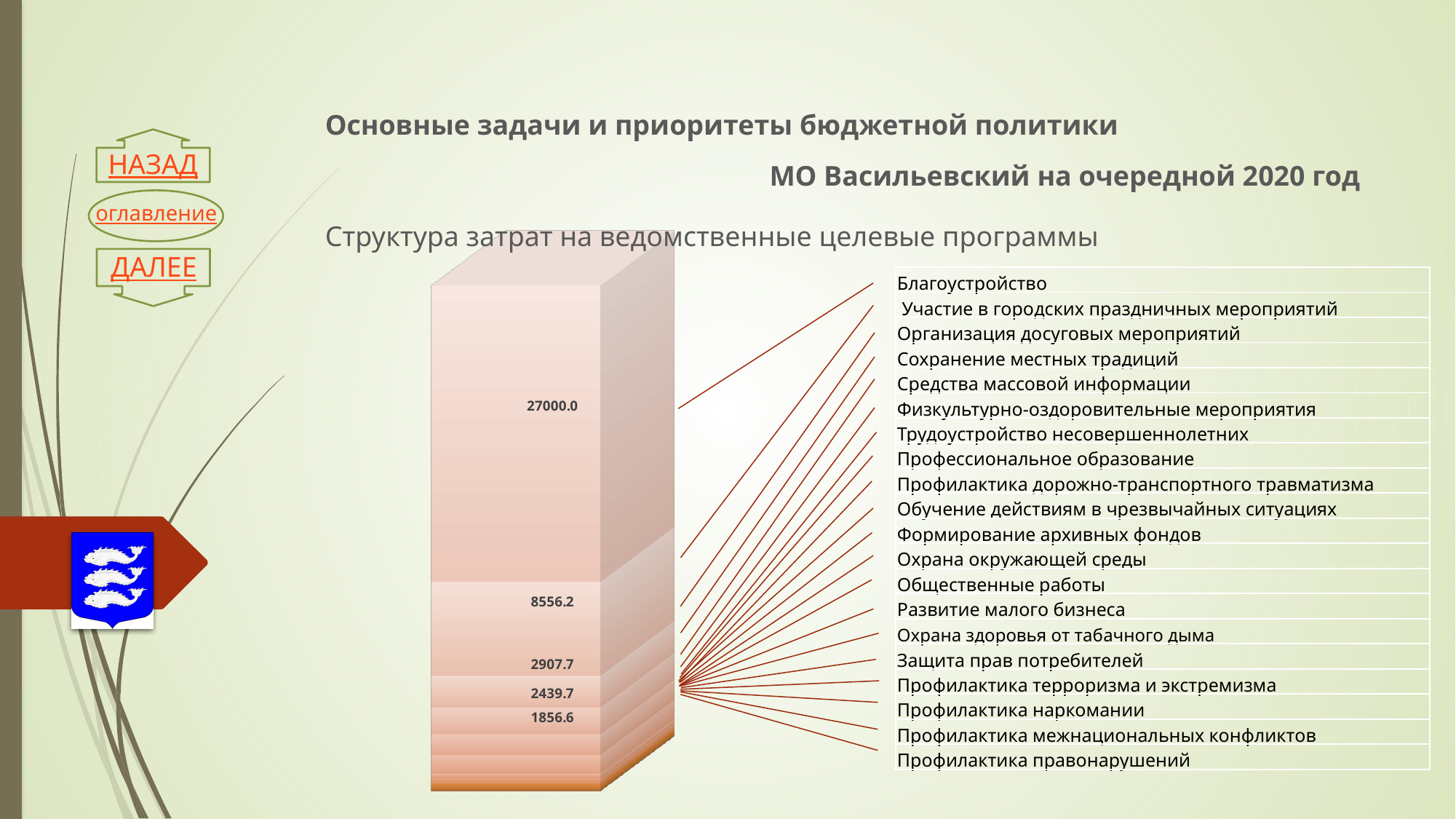
What is the difference between the segments labelled 2907.7 and 2439.7? 468.0 How many segments of the bar have a printed data label? 5 What is the value shown for Благоустройство? 27000.0 What is the value printed on the largest segment of the bar? 27000.0 Which is larger, the segment labelled 8556.2 or the segment labelled 2907.7? 8556.2 How many categories does the legend of the chart list? 20 What is the difference between the segments labelled 2439.7 and 1856.6? 583.1 What is the title of the chart on the slide? Структура затрат на ведомственные целевые программы Which category has the largest segment in the bar? Благоустройство What is the smallest value printed as a data label on the bar? 1856.6 What kind of chart is shown on the slide? Stacked bar chart What is the difference between the segment labelled 27000.0 and the segment labelled 8556.2? 18443.8